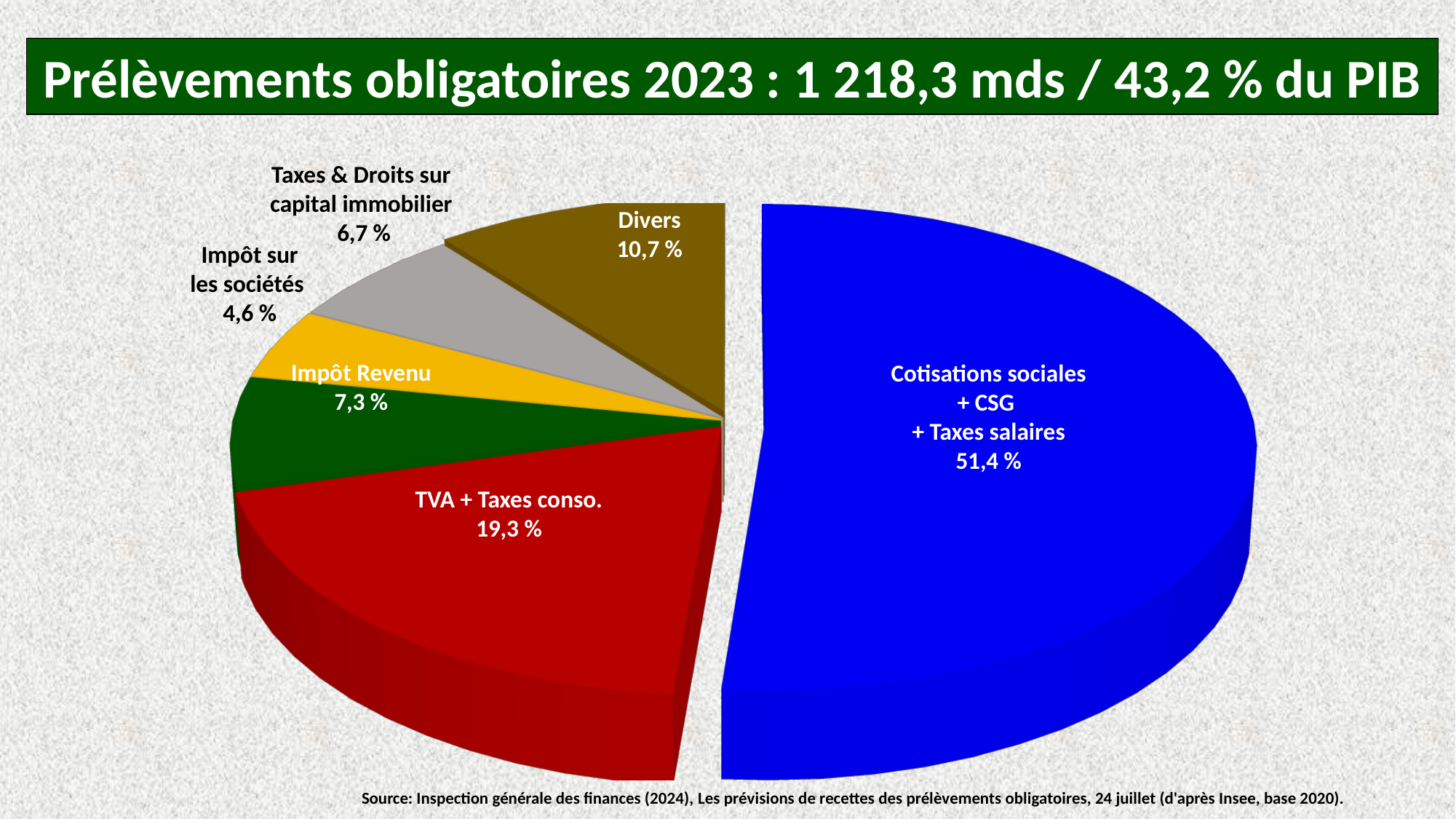
What colour is the "TVA + Taxes conso." slice? red What is the difference in percentage points between "Divers" and "Impôt Revenu"? 3,4 How many slices does the pie chart have? 6 Which slice of the pie is the largest? Cotisations sociales + CSG + Taxes salaires Which slice of the pie is the smallest? Impôt sur les sociétés What is the title of the chart on the slide? Prélèvements obligatoires 2023 : 1 218,3 mds / 43,2 % du PIB Which is larger, "Impôt Revenu" or "Taxes & Droits sur capital immobilier"? Impôt Revenu What kind of chart is shown on the slide? pie chart What share of the pie does "TVA + Taxes conso." represent? 19,3 % What is the value shown for "Divers"? 10,7 % What is the value shown for "Impôt sur les sociétés"? 4,6 % What is the value shown for "Taxes & Droits sur capital immobilier"? 6,7 %